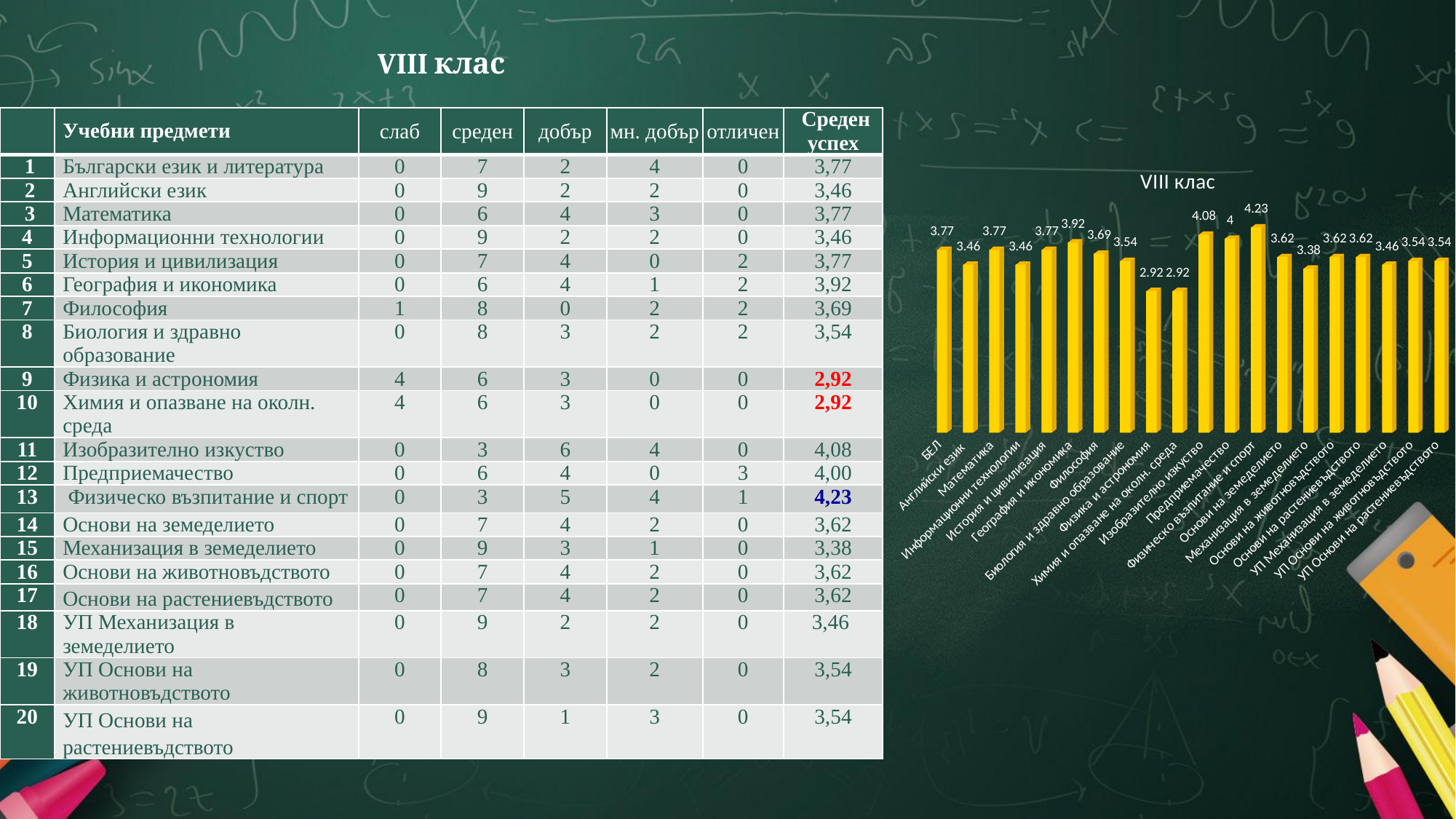
What is the value for Изобразително изкуство in the chart? 4.08 What is the lowest value shown in the chart? 2.92 What is the title of the chart? VIII клас What is the difference between the values for Физическо възпитание и спорт and Физика и астрономия? 1.31 What type of chart is shown on the slide? bar chart Which is larger, the value for Предприемачество or the value for Биология и здравно образование? Предприемачество What is the value for География и икономика in the chart? 3.92 What is the difference between the values for География и икономика and Механизация в земеделието? 0.54 What is the value for Философия in the chart? 3.69 How many bars (categories) does the chart show? 20 Which category has the highest value in the chart? Физическо възпитание и спорт What is the value for Механизация в земеделието in the chart? 3.38